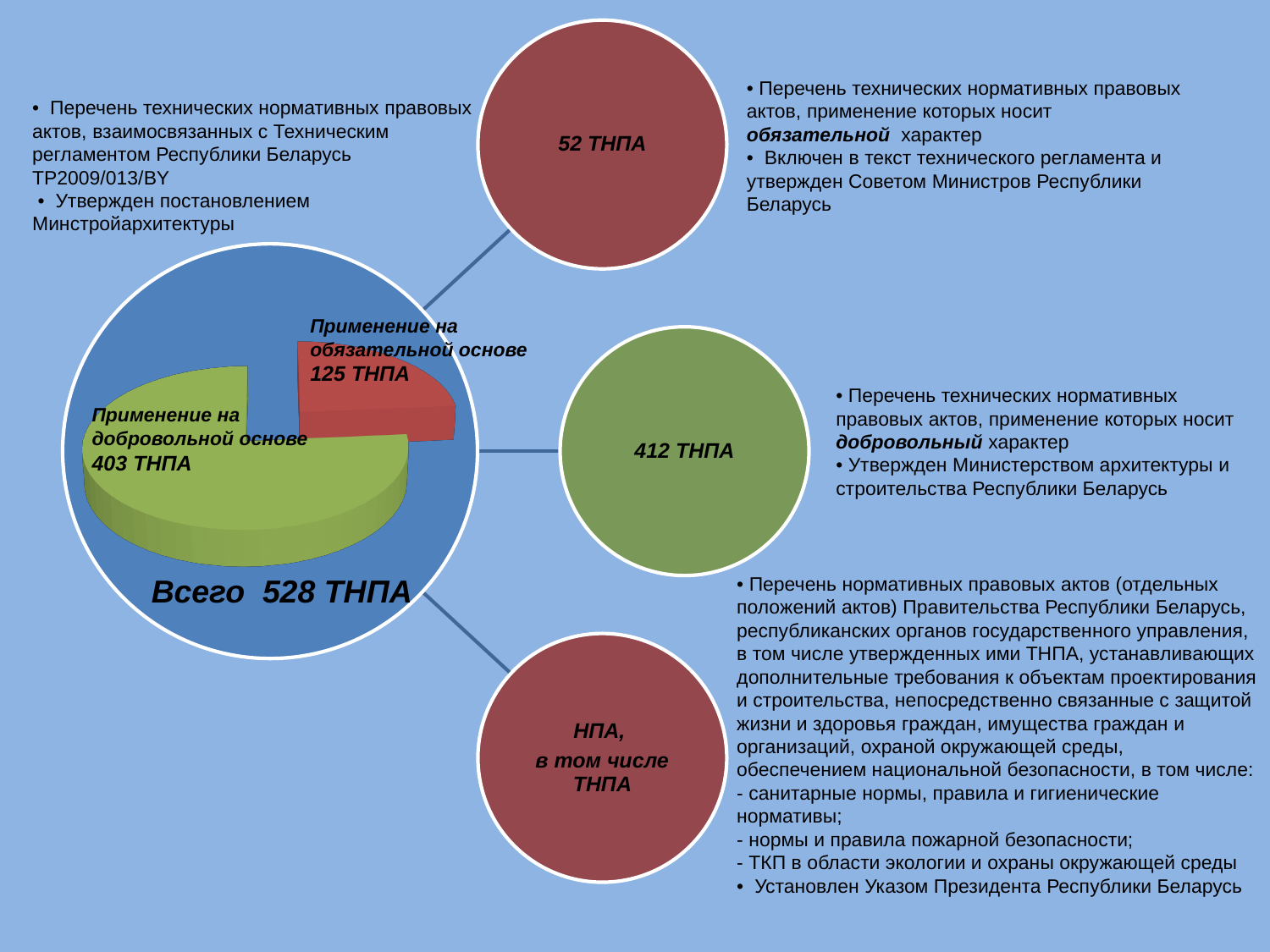
Which slice of the pie chart is the largest? Применение на добровольной основе Which is larger in the pie chart: the voluntary-basis slice or the mandatory-basis slice? Применение на добровольной основе What value is shown for the slice "Применение на добровольной основе" in the pie chart? 403 ТНПА What type of chart is shown on the slide? Pie chart What colour is the slice for "Применение на обязательной основе" in the pie chart? Red How many slices does the pie chart have? 2 Which slice of the pie chart is the smallest? Применение на обязательной основе What is the difference between the voluntary-basis slice (403) and the mandatory-basis slice (125) in the pie chart? 278 ТНПА What colour is the slice for "Применение на добровольной основе" in the pie chart? Green What value is shown for the slice "Применение на обязательной основе" in the pie chart? 125 ТНПА What total is printed below the pie chart? Всего 528 ТНПА To the nearest whole percent, what share of the total 528 ТНПА does the mandatory-basis slice (125 ТНПА) represent? 24%